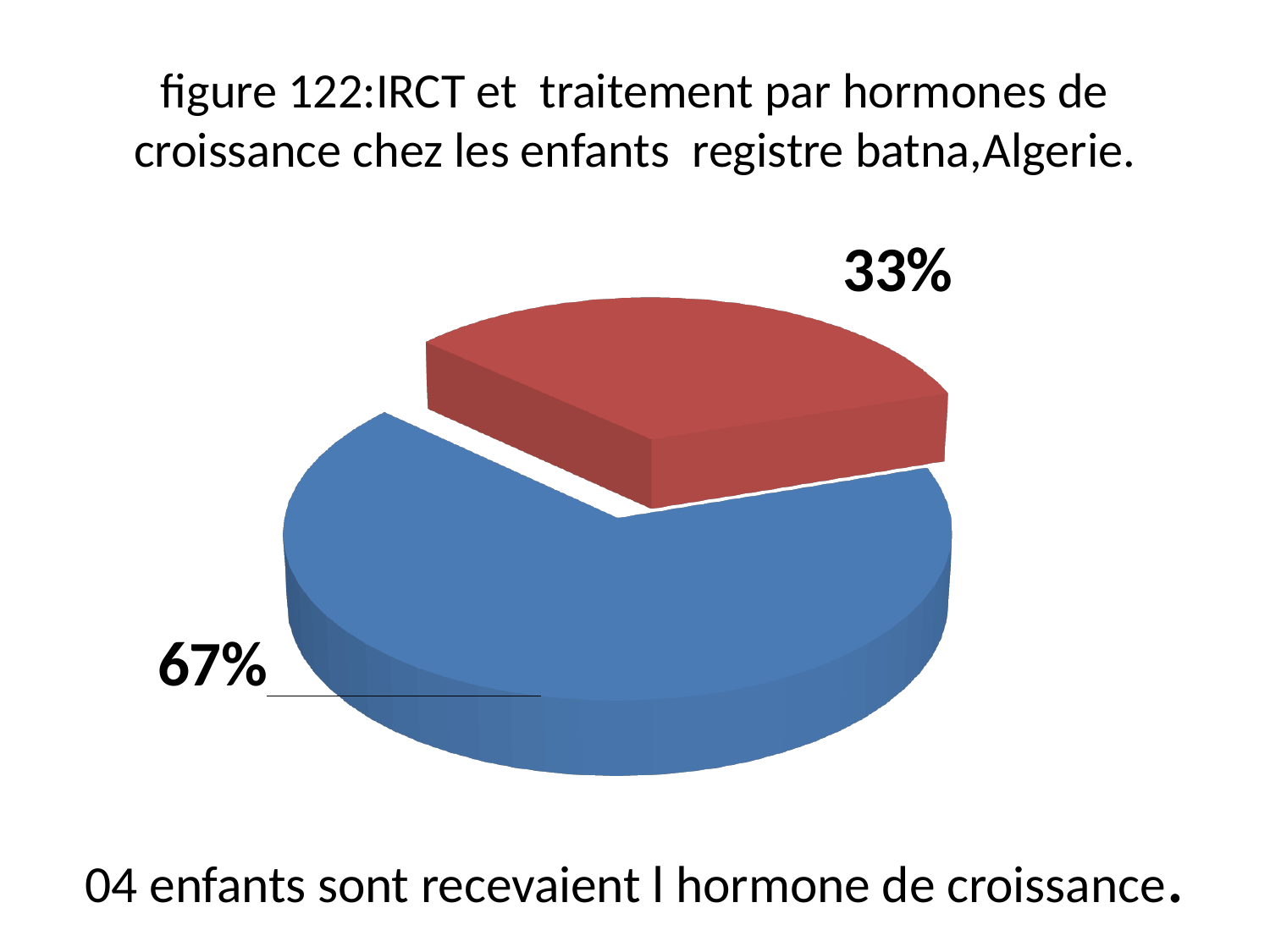
Which slice of the pie chart is the largest? the blue slice (67%) Which slice of the pie chart is pulled out (exploded) from the rest? the red slice (33%) What is the difference in percentage points between the blue slice and the red slice? 34 What is the figure number given in the chart title? figure 122 Which is larger, the blue slice or the red slice? the blue slice What percentage is shown for the red slice of the pie chart? 33% Which slice of the pie chart is the smallest? the red slice (33%) What share of the pie does the red slice represent? 33% What percentage is shown for the blue slice of the pie chart? 67% How many slices does the pie chart have? 2 What kind of chart is shown on the slide? pie chart Is the value for the blue slice greater or less than 50%? greater